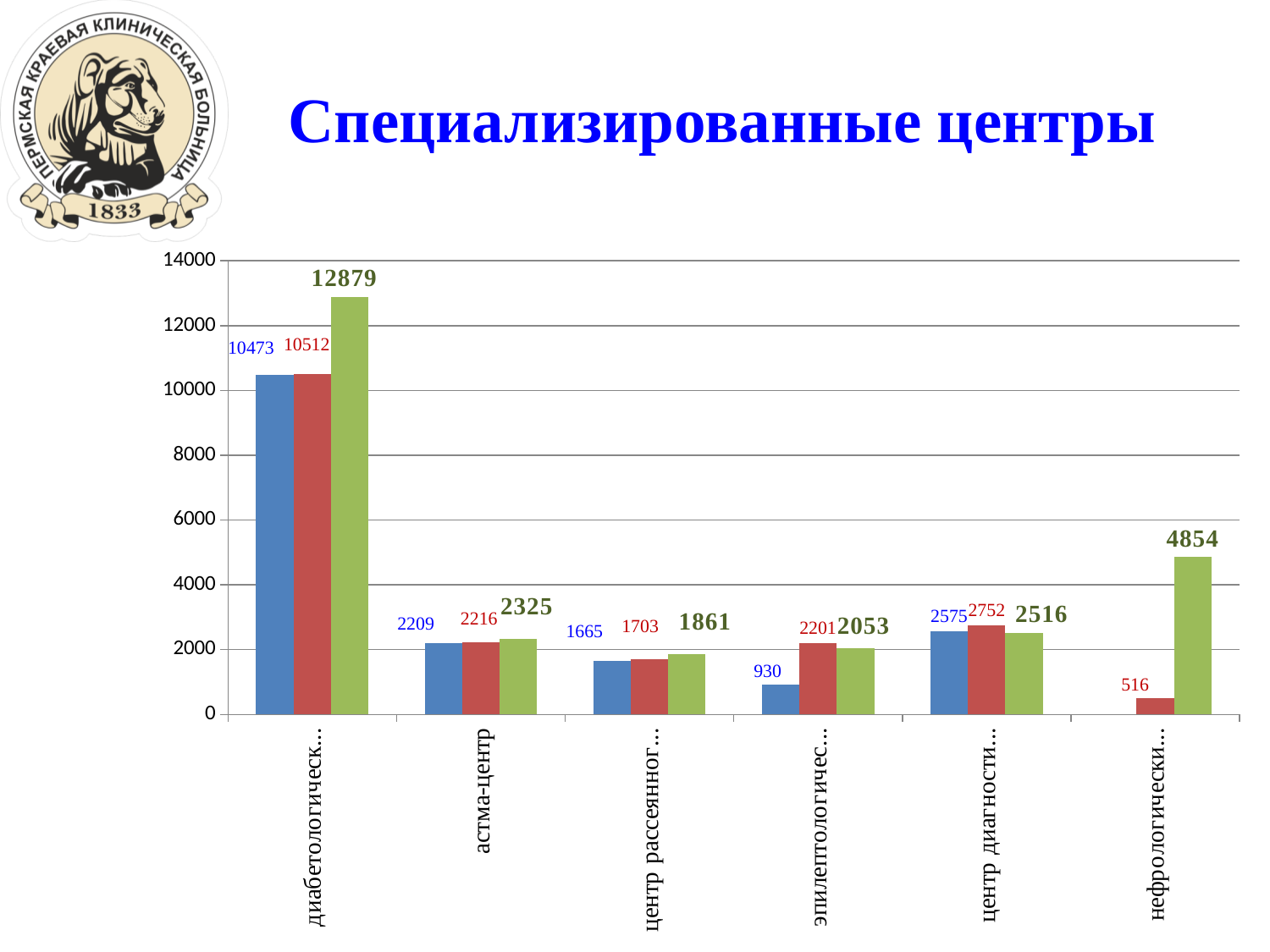
What is the value of the green bar for the category labelled 'центр рассеянног...'? 1861 Which category has the highest green bar? диабетологическ... What is the value of the blue bar for астма-центр? 2209 What is the value of the red bar for the category labelled 'нефрологически...'? 516 What kind of chart is shown on the slide? bar chart Which category has the lowest blue bar? эпилептологичес... Is the green bar for the category labelled 'нефрологически...' greater or less than 4000? greater What is the title of the slide containing the chart? Специализированные центры How many categories are shown along the x axis of the chart? 6 What is the difference between the green bar (12879) and the blue bar (10473) for the category labelled 'диабетологическ...'? 2406 For the category labelled 'эпилептологичес...', which is larger, the red bar or the green bar? the red bar What is the value of the green bar for астма-центр? 2325